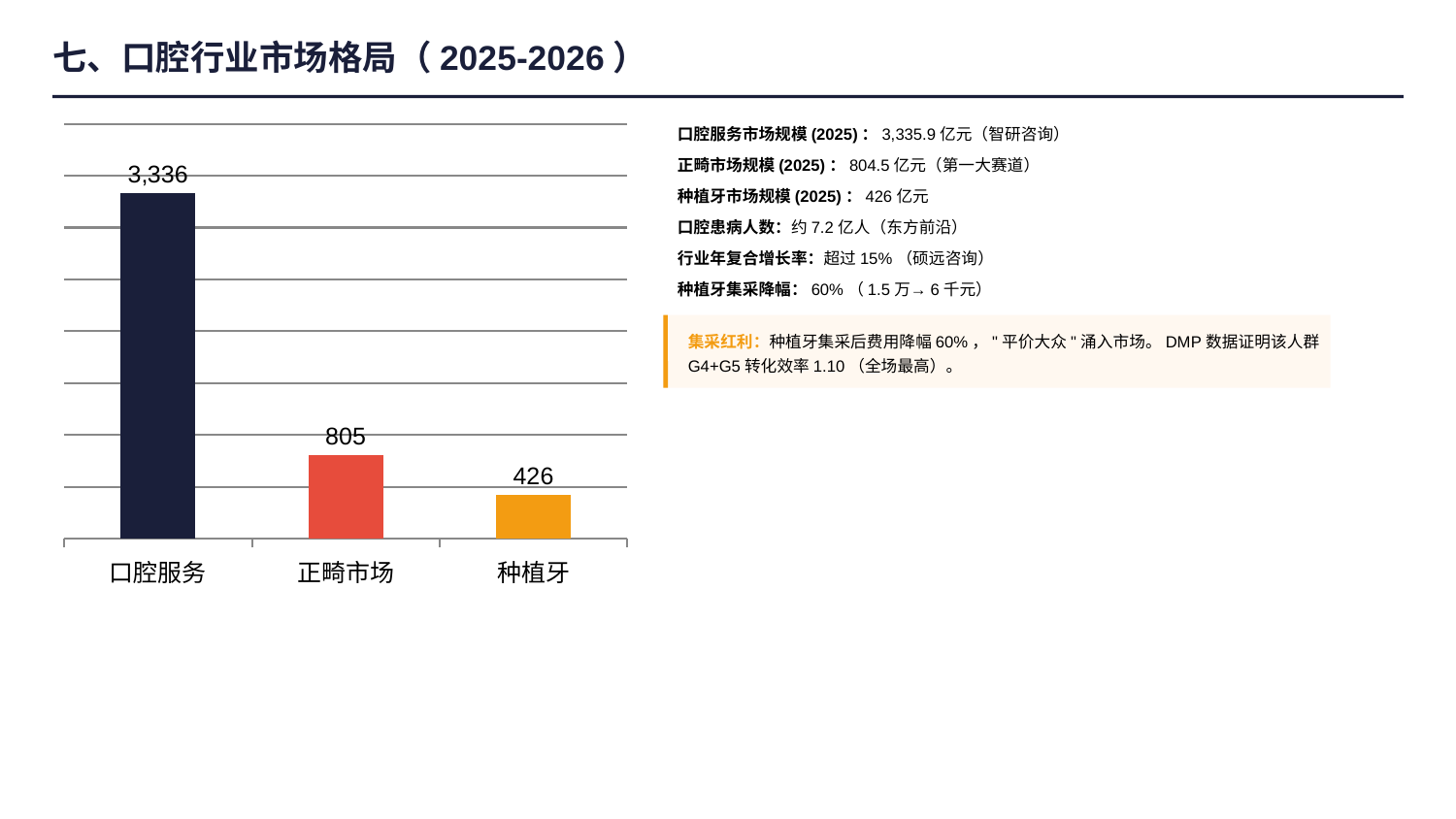
How many categories are shown in the bar chart? 3 Which category has the highest value in the bar chart? 口腔服务 What colour is the bar for 种植牙? Orange What is the difference between the values for 口腔服务 and 正畸市场? 2,531 What is the value for 正畸市场 in the bar chart? 805 Which is larger, the value for 正畸市场 or the value for 种植牙? 正畸市场 What is the value for 种植牙 in the bar chart? 426 What kind of chart is shown on the slide? Bar chart What is the difference between the values for 正畸市场 and 种植牙? 379 Which category has the lowest value in the bar chart? 种植牙 What is the value for 口腔服务 in the bar chart? 3,336 What is the difference between the values for 口腔服务 and 种植牙? 2,910